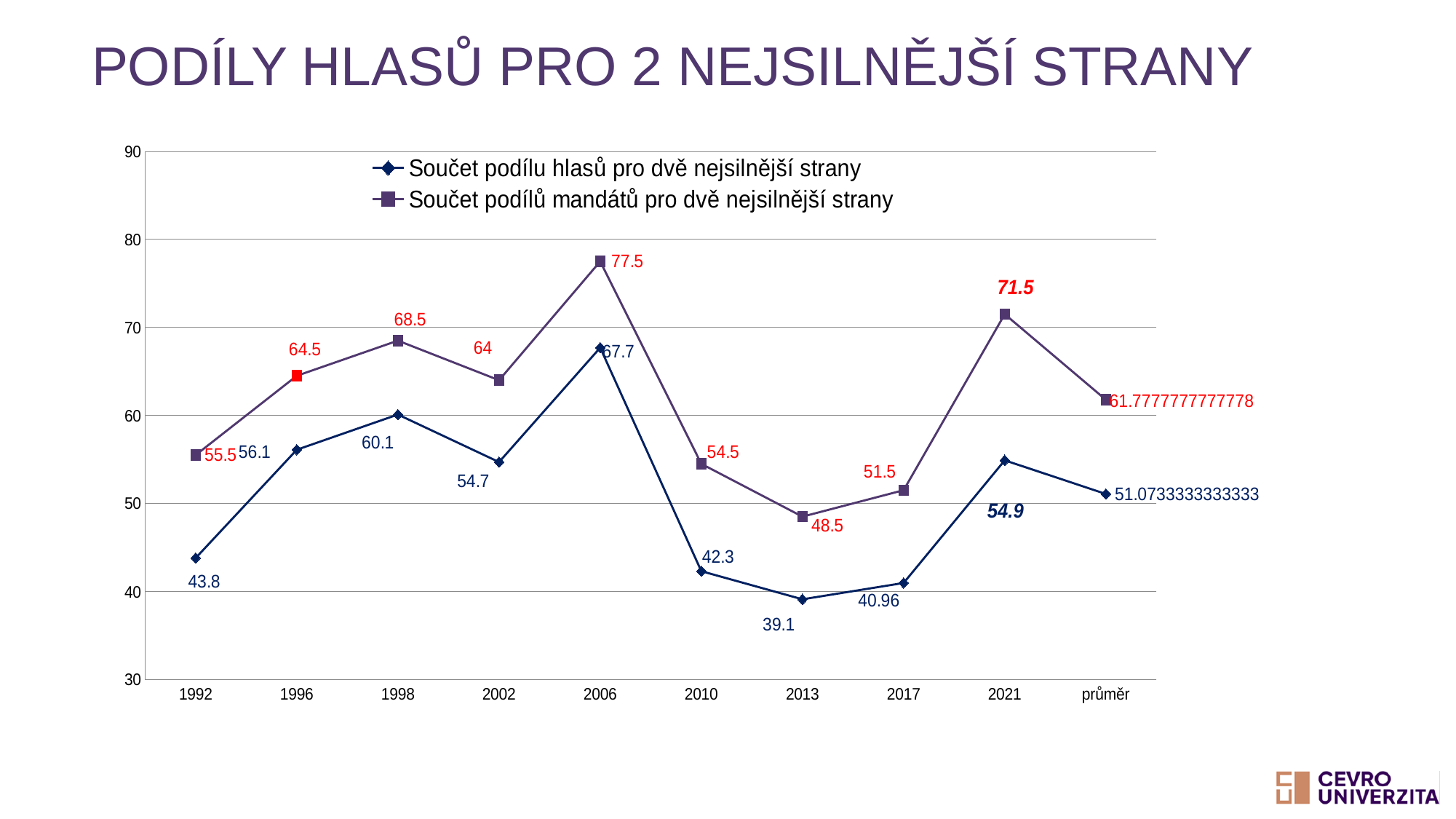
What is the difference between the two series in 2006? 9.8 What is the value of 'Součet podílů mandátů pro dvě nejsilnější strany' in 2021? 71.5 In which year is 'Součet podílů mandátů pro dvě nejsilnější strany' highest? 2006 What kind of chart is shown on the slide? line chart In which year is 'Součet podílu hlasů pro dvě nejsilnější strany' lowest? 2013 How many series does the legend list? 2 What is the value of 'Součet podílu hlasů pro dvě nejsilnější strany' in 2006? 67.7 How many categories are shown on the x axis? 10 Is the value of 'Součet podílů mandátů pro dvě nejsilnější strany' in 2013 greater or less than 50? less What is the value of 'Součet podílu hlasů pro dvě nejsilnější strany' in 2017? 40.96 Does 'Součet podílu hlasů pro dvě nejsilnější strany' rise or fall from 2006 to 2013? fall Which is larger: 'Součet podílu hlasů pro dvě nejsilnější strany' in 1998 or in 2002? 1998